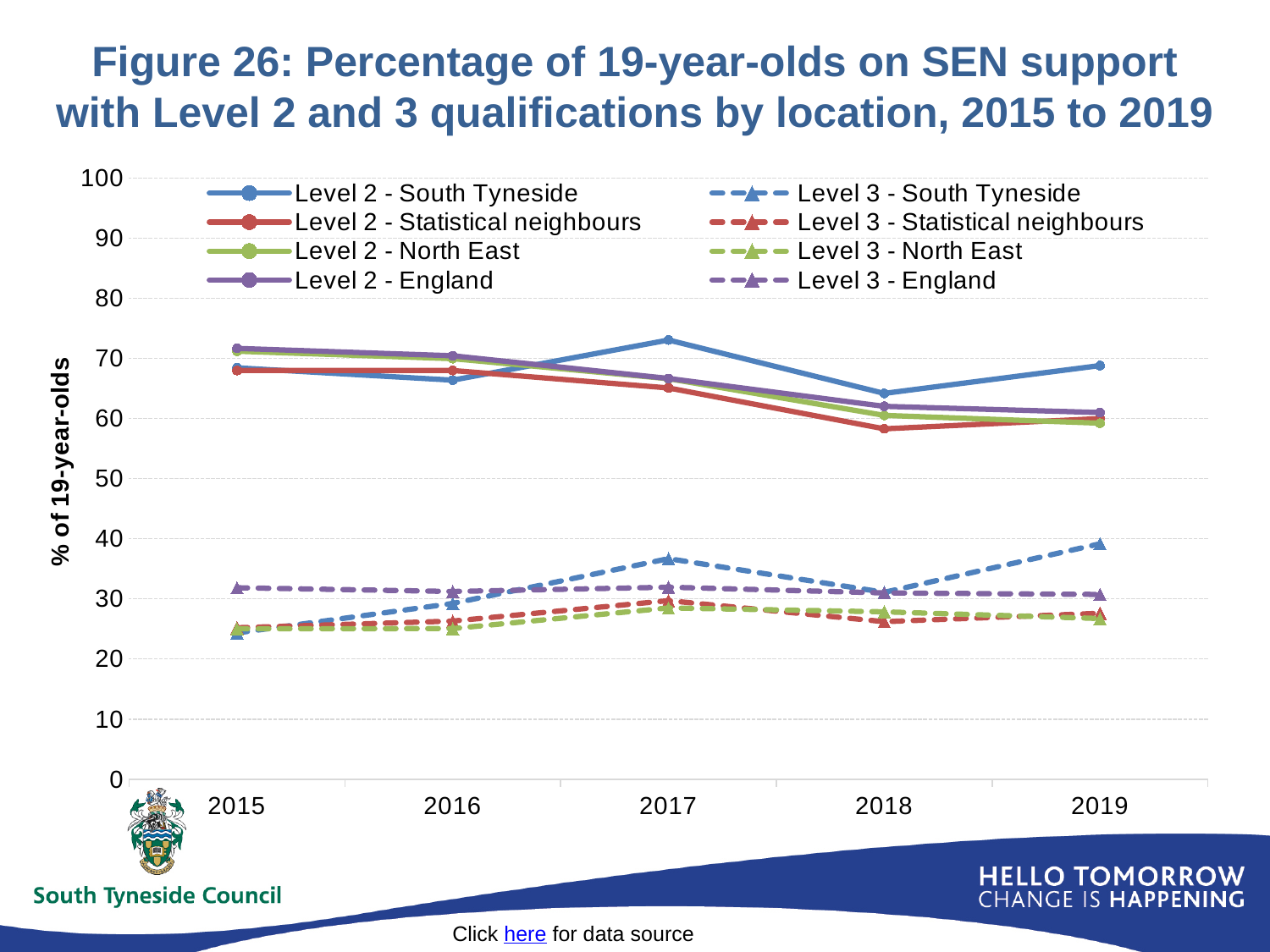
Is the value for Level 3 - South Tyneside in 2019 greater or less than 30? greater How are the Level 3 series drawn differently from the Level 2 series? Dashed lines with triangle markers Is the value for Level 2 - Statistical neighbours in 2018 greater or less than 60? less What kind of chart is shown on the slide? Line chart In 2019, which is larger: Level 3 - South Tyneside or Level 3 - England? Level 3 - South Tyneside In which year is Level 2 - South Tyneside at its lowest? 2018 How many years are plotted along the x axis? 5 What is the label on the y axis? % of 19-year-olds How many series does the legend list? 8 Is the value for Level 2 - South Tyneside in 2017 greater or less than 70? greater Does the Level 2 - England series rise or fall from 2015 to 2019? Fall In which year is Level 3 - South Tyneside at its highest? 2019